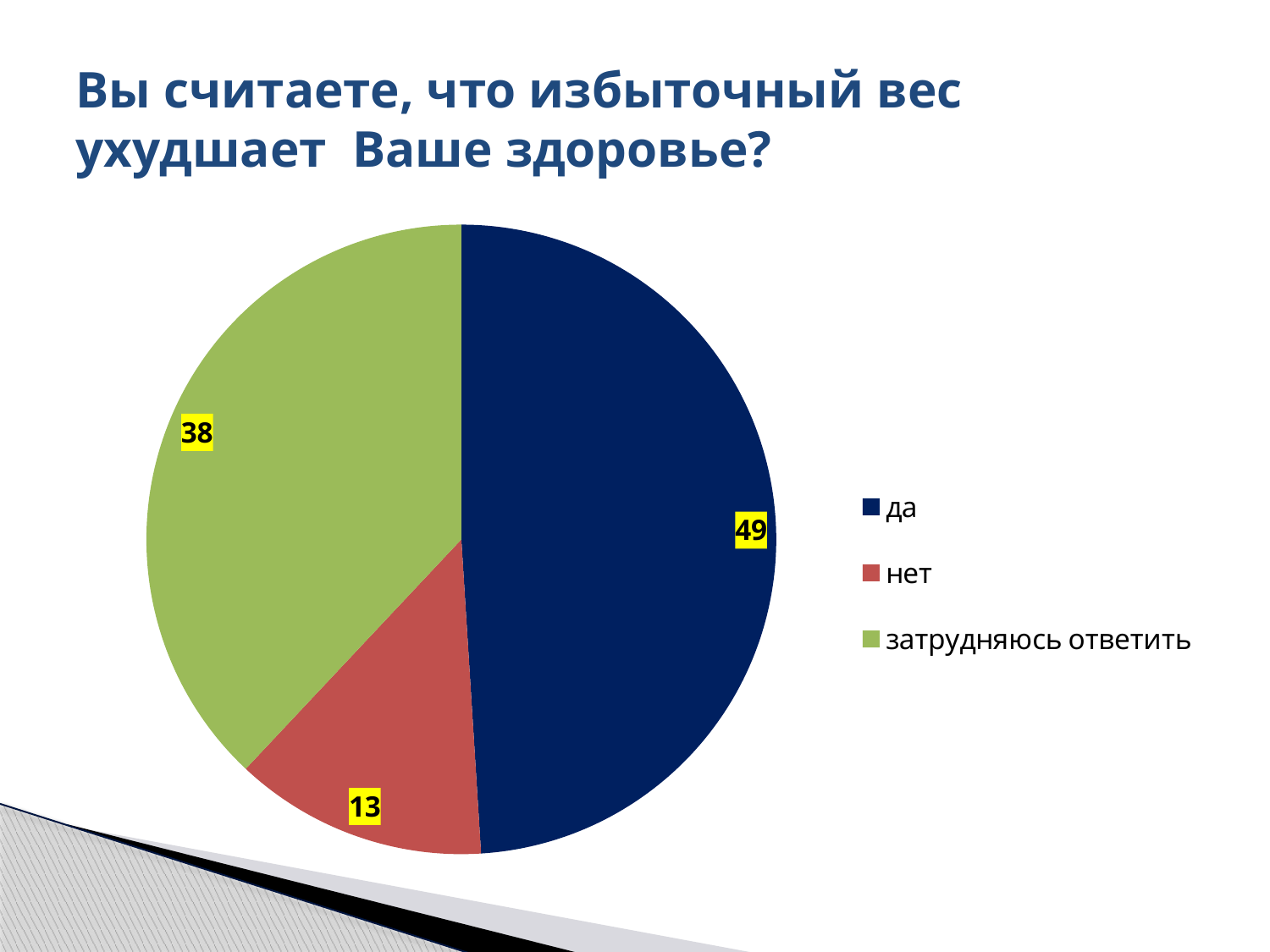
What value is shown for the "затрудняюсь ответить" slice? 38 How many slices does the pie chart have? 3 How many entries does the legend list? 3 Which category has the smallest slice? нет What is the difference between the values for "да" and "затрудняюсь ответить"? 11 What is the difference between the values for "да" and "нет"? 36 Which category has the largest slice? да What kind of chart is shown on the slide? pie chart What value is shown for the "да" slice? 49 What colour is the "нет" slice? red What value is shown for the "нет" slice? 13 Which is larger, the value for "затрудняюсь ответить" or the value for "нет"? затрудняюсь ответить